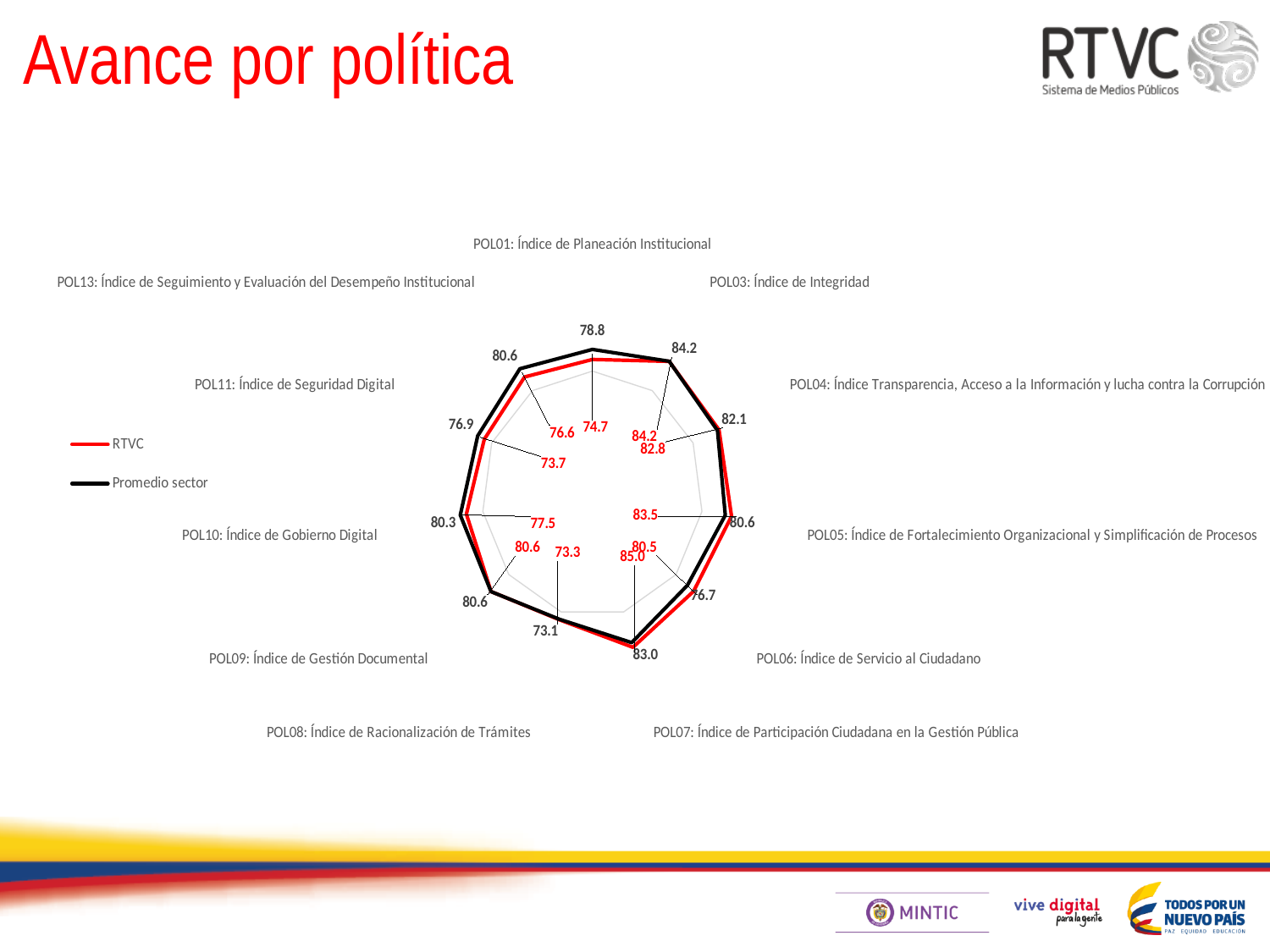
What is the Promedio sector value for POL01: Índice de Planeación Institucional? 78.8 How many series does the legend list? 2 What is the RTVC value for POL11: Índice de Seguridad Digital? 73.7 For POL13: Índice de Seguimiento y Evaluación del Desempeño Institucional, which is larger, the RTVC value or the Promedio sector value? Promedio sector What are the two series named in the legend? RTVC and Promedio sector What is the RTVC value for POL01: Índice de Planeación Institucional? 74.7 What is the Promedio sector value for POL08: Índice de Racionalización de Trámites? 73.1 What is the difference between the Promedio sector and RTVC values for POL01: Índice de Planeación Institucional? 4.1 What kind of chart is shown on the slide? Radar chart Which category has the lowest Promedio sector value? POL08: Índice de Racionalización de Trámites How many policy categories (axes) does the radar chart have? 11 Which category has the highest Promedio sector value? POL03: Índice de Integridad